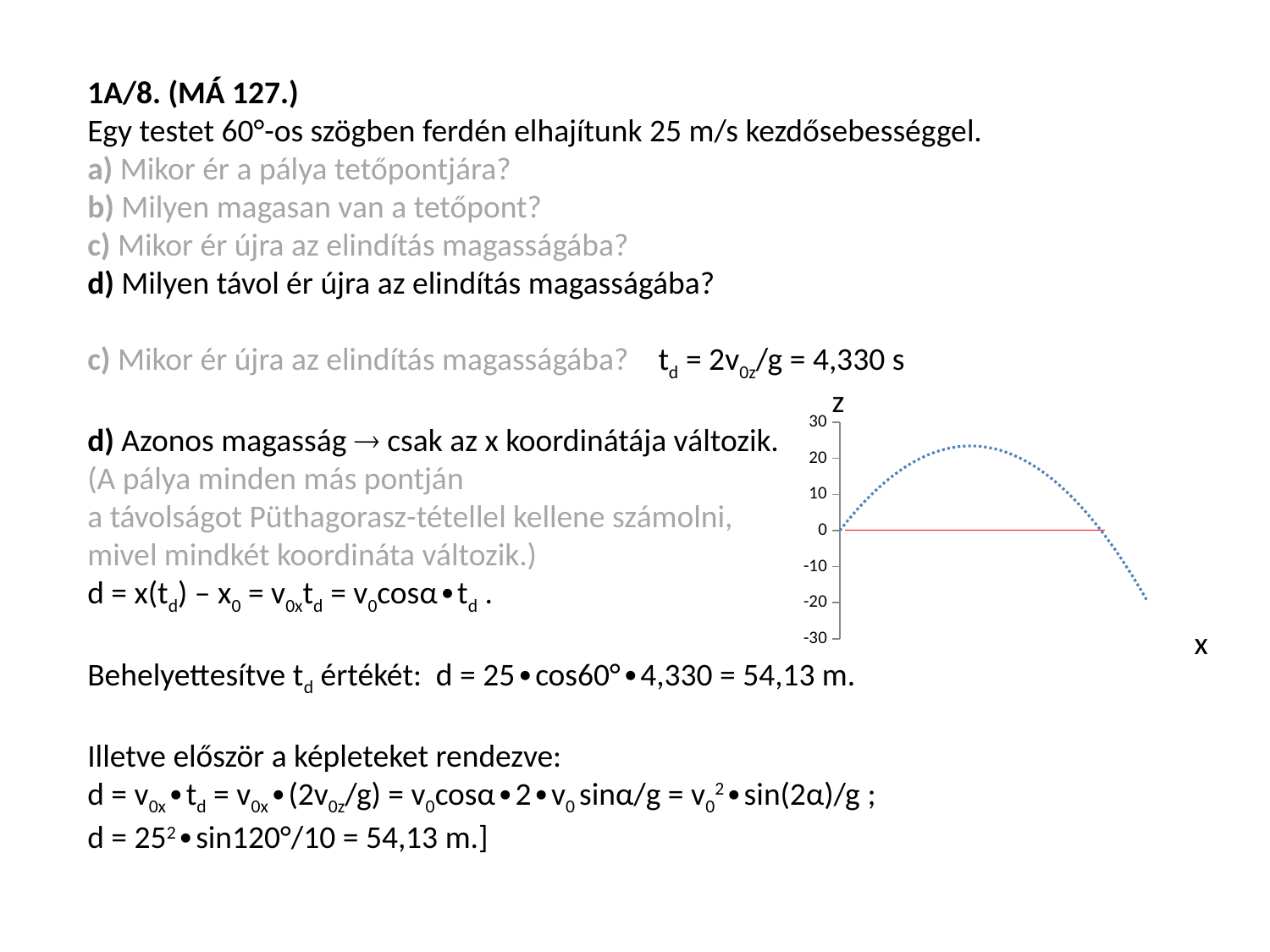
What is the highest tick value shown on the z axis? 30 At which z value does the red horizontal line lie? 0 What kind of chart is shown on the slide? line chart Is the right-hand end of the dotted curve greater or less than -30 on the z axis? greater What is the label of the horizontal axis of the chart? x How does the dotted curve behave as x increases from left to right? rises then falls Is the right-hand end of the dotted curve greater or less than -10 on the z axis? less Is the highest point of the dotted curve greater or less than 20 on the z axis? greater What is the label of the vertical axis of the chart? z